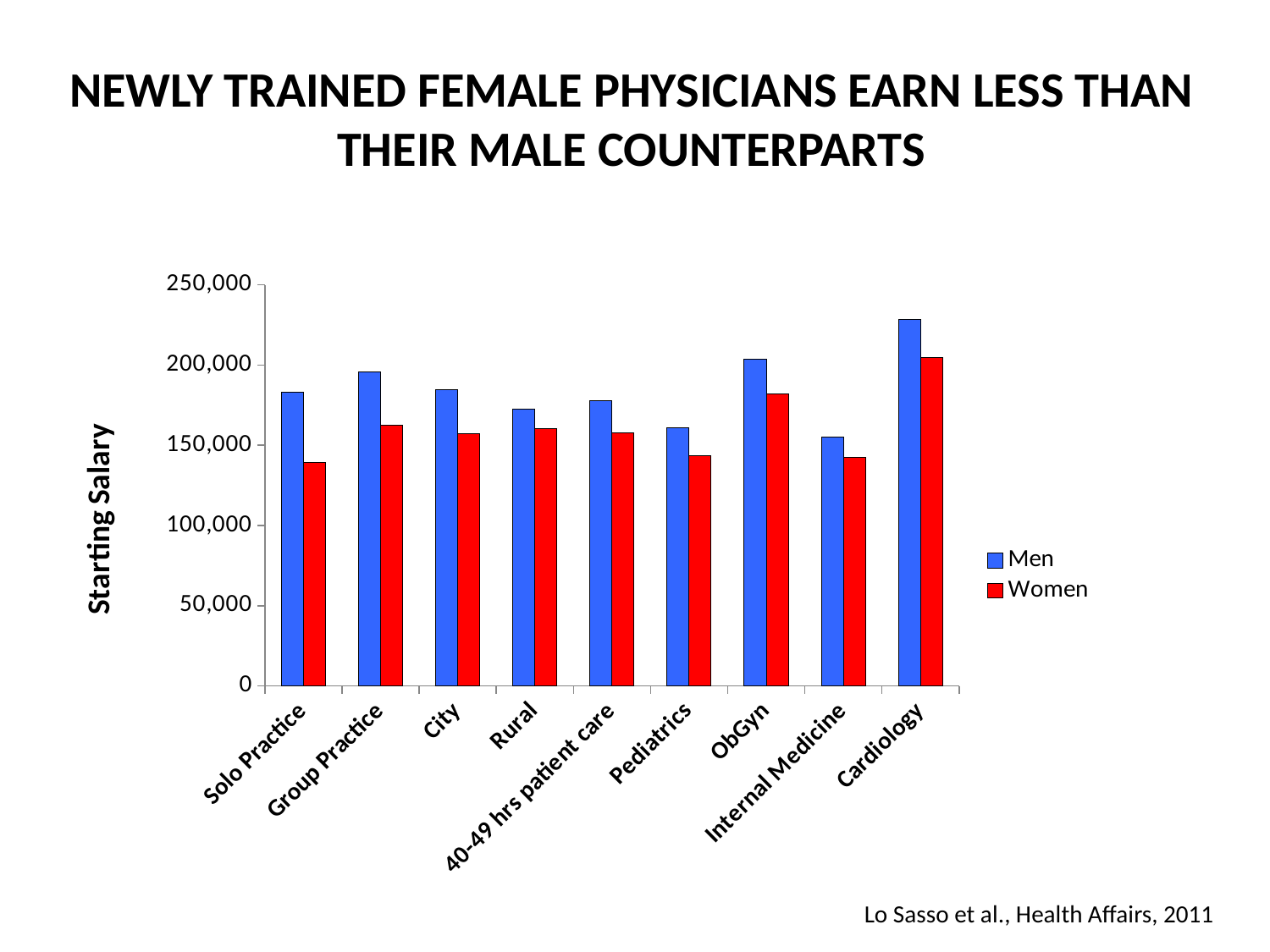
How many categories are shown on the x axis? 9 Is the starting salary for Women in ObGyn greater or less than 150,000? greater Is the starting salary for Women in Solo Practice greater or less than 150,000? less Which category has the highest starting salary for Women? Cardiology Which category has the lowest starting salary for Men? Internal Medicine Which category has the highest starting salary for Men? Cardiology What kind of chart is shown on the slide? bar chart Is the starting salary for Men in Rural greater or less than 200,000? less In Solo Practice, which series has the larger starting salary, Men or Women? Men What is the label of the y axis? Starting Salary How many series does the legend list? 2